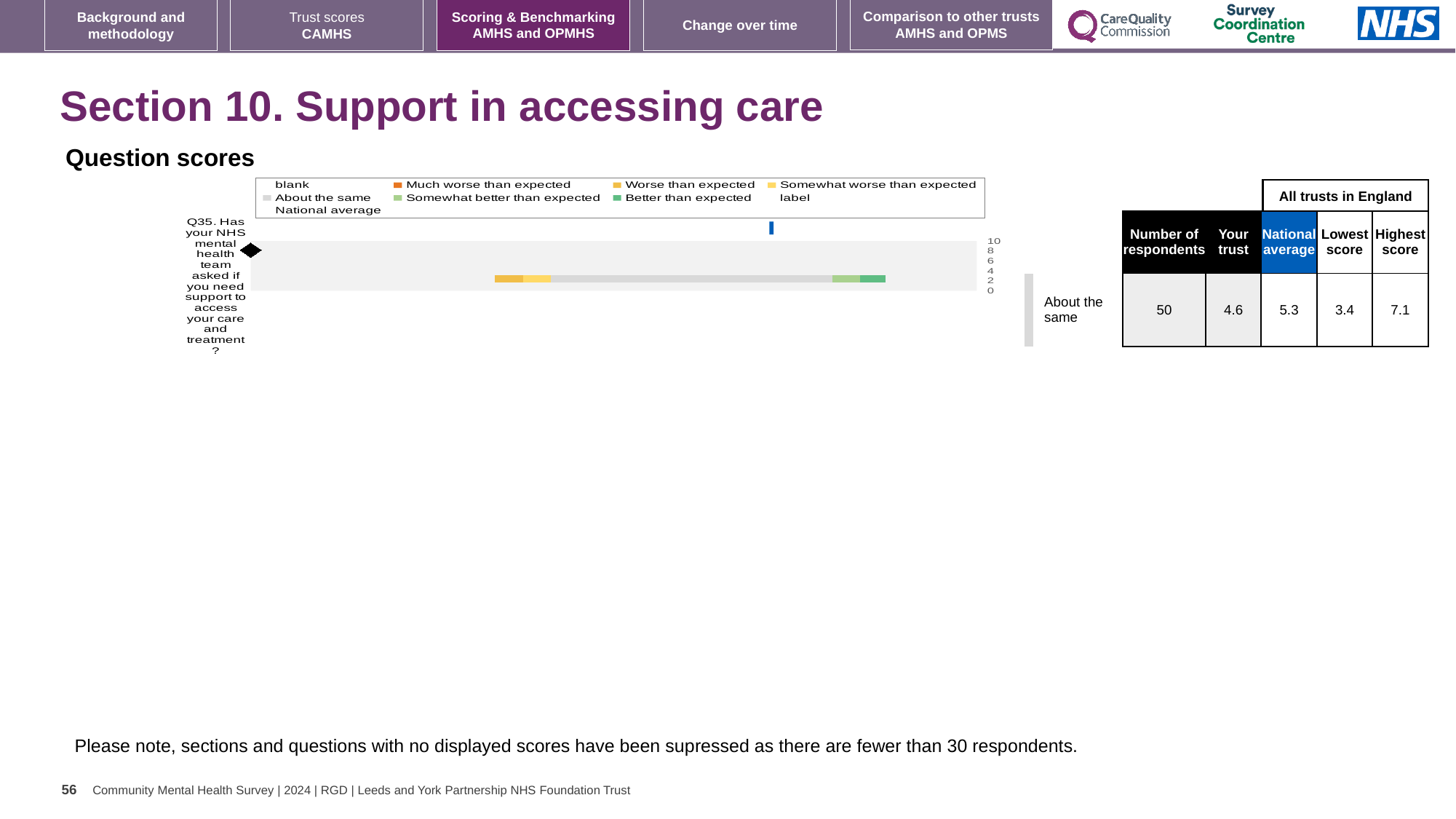
How many questions are plotted in the Question scores chart? 1 What is the national average score for Q35? 5.3 What is the difference between the highest and lowest trust scores for Q35? 3.7 Which benchmark category is the trust's Q35 score placed in? About the same What is the highest score among all trusts in England for Q35? 7.1 What is the lowest score among all trusts in England for Q35? 3.4 What is the maximum value shown on the score axis of the chart? 10 Which is larger for Q35, the trust's score or the national average? National average How many respondents answered Q35? 50 By how much does the national average exceed the trust's score for Q35? 0.7 What is the 'Your trust' score for Q35 (support to access care and treatment)? 4.6 What kind of chart is used to show the Q35 question score? bar chart